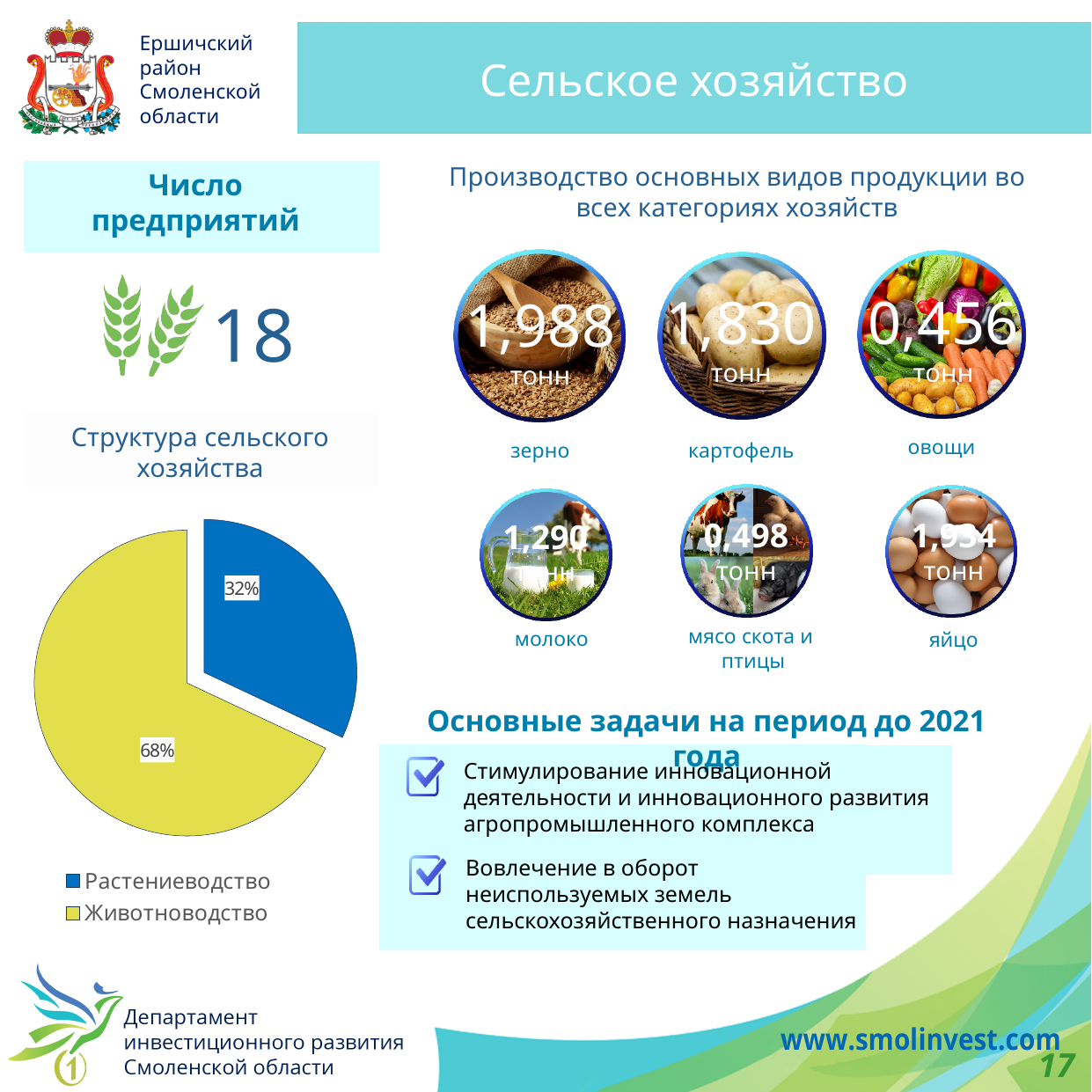
In the pie chart "Структура сельского хозяйства", what share does Животноводство have? 68% In the pie chart "Структура сельского хозяйства", what share does Растениеводство have? 32% How many slices does the pie chart "Структура сельского хозяйства" have? 2 What colour is the Животноводство slice in the pie chart "Структура сельского хозяйства"? Yellow How many entries does the legend of the pie chart "Структура сельского хозяйства" list? 2 What type of chart is shown under the heading "Структура сельского хозяйства"? Pie chart Which category has the largest slice in the pie chart "Структура сельского хозяйства"? Животноводство What colour is the Растениеводство slice in the pie chart "Структура сельского хозяйства"? Blue Which category has the smallest slice in the pie chart "Структура сельского хозяйства"? Растениеводство In the pie chart "Структура сельского хозяйства", what share of the whole does the Животноводство slice represent? 68% In the pie chart "Структура сельского хозяйства", which is larger: Растениеводство or Животноводство? Животноводство In the pie chart "Структура сельского хозяйства", by how many percentage points does Животноводство exceed Растениеводство? 36 percentage points